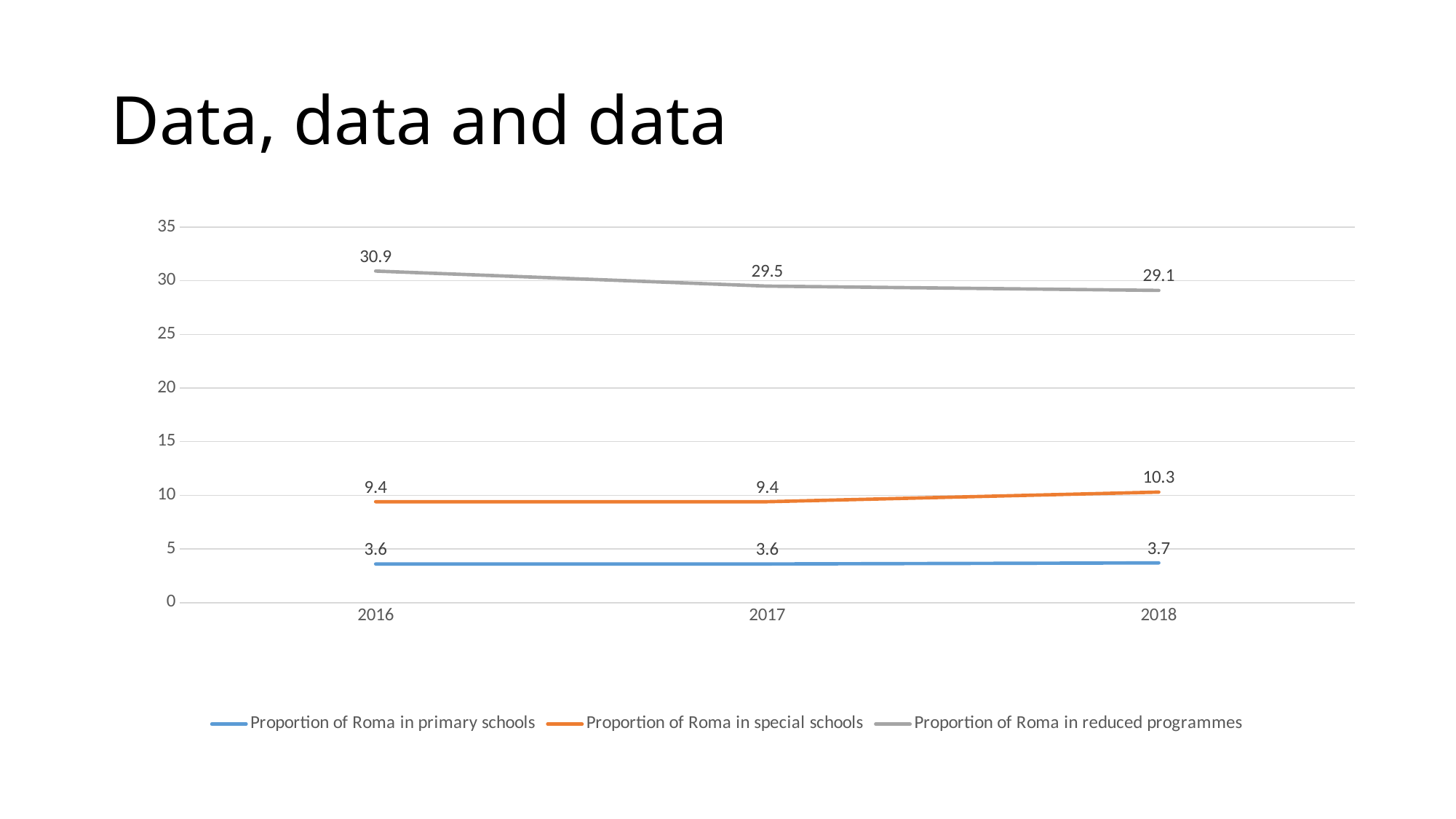
In which year is the Proportion of Roma in reduced programmes highest? 2016 What is the value for Proportion of Roma in special schools in 2018? 10.3 In which year is the Proportion of Roma in reduced programmes lowest? 2018 Does the Proportion of Roma in reduced programmes rise or fall from 2016 to 2018? Fall How many years are shown on the x axis? 3 What is the value for Proportion of Roma in reduced programmes in 2016? 30.9 What kind of chart is shown on the slide? Line chart What colour is the line for Proportion of Roma in special schools? Orange Which is larger in 2018: the Proportion of Roma in special schools or the Proportion of Roma in primary schools? Proportion of Roma in special schools What is the value for Proportion of Roma in primary schools in 2017? 3.6 How many series does the legend list? 3 What is the difference between the Proportion of Roma in reduced programmes in 2016 and in 2018? 1.8